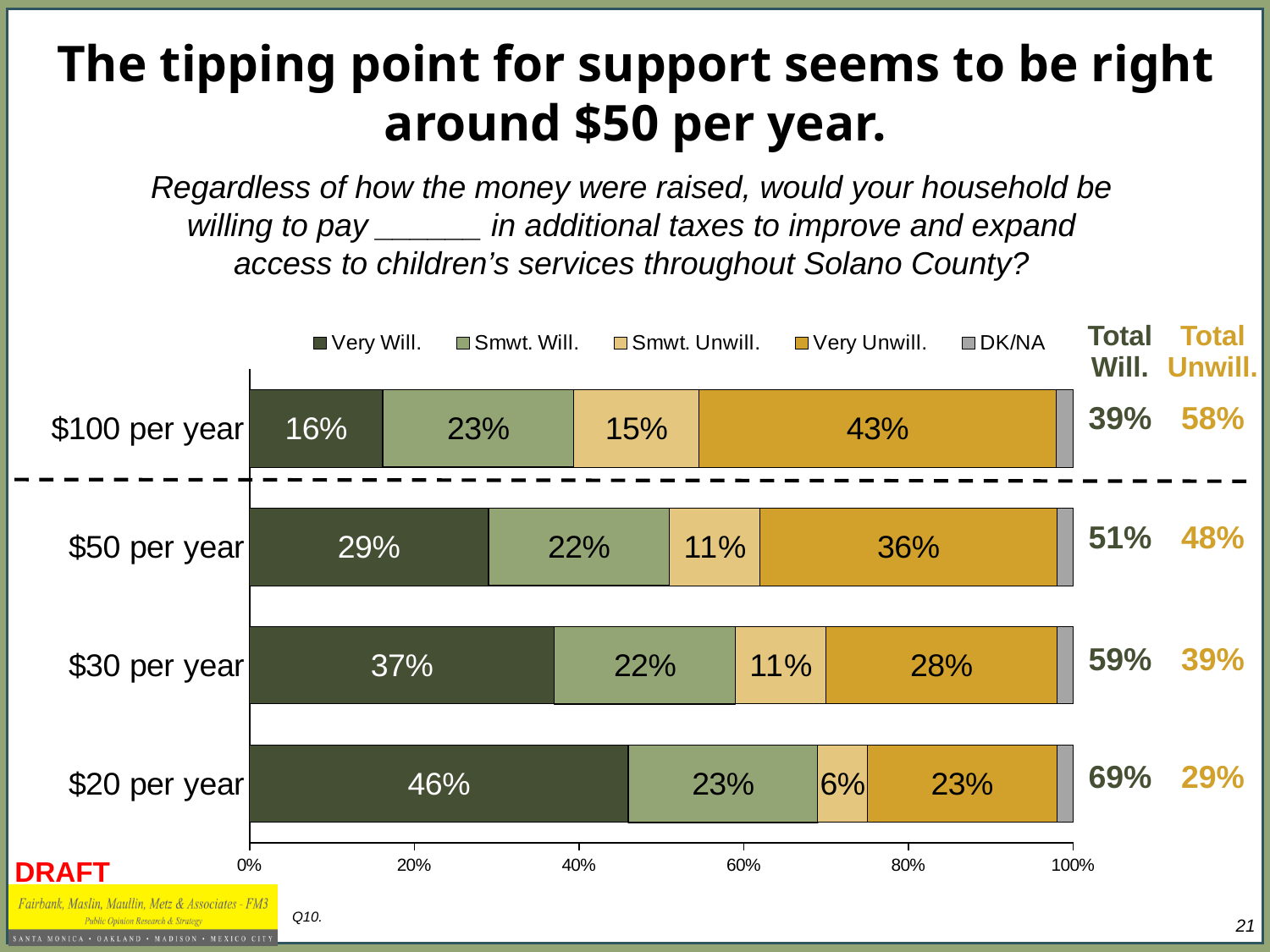
How many amounts per year are shown on the chart? 4 How many series does the legend list? 5 What is the difference between the "Very Will." percentages for $20 per year and $100 per year? 30% Which amount per year has the lowest "Very Unwill." percentage? $20 per year What is the "Total Will." figure shown for $30 per year? 59% Which series is shown in the darkest green colour in the legend? Very Will. Is the "Very Unwill." percentage larger for $50 per year or for $30 per year? $50 per year Which amount per year has the highest "Very Will." percentage? $20 per year What percentage of respondents are "Very Will." to pay $20 per year? 46% What kind of chart is shown on the slide? Stacked bar chart What is the "Smwt. Unwill." value for $50 per year? 11% What percentage of respondents are "Very Unwill." to pay $100 per year? 43%